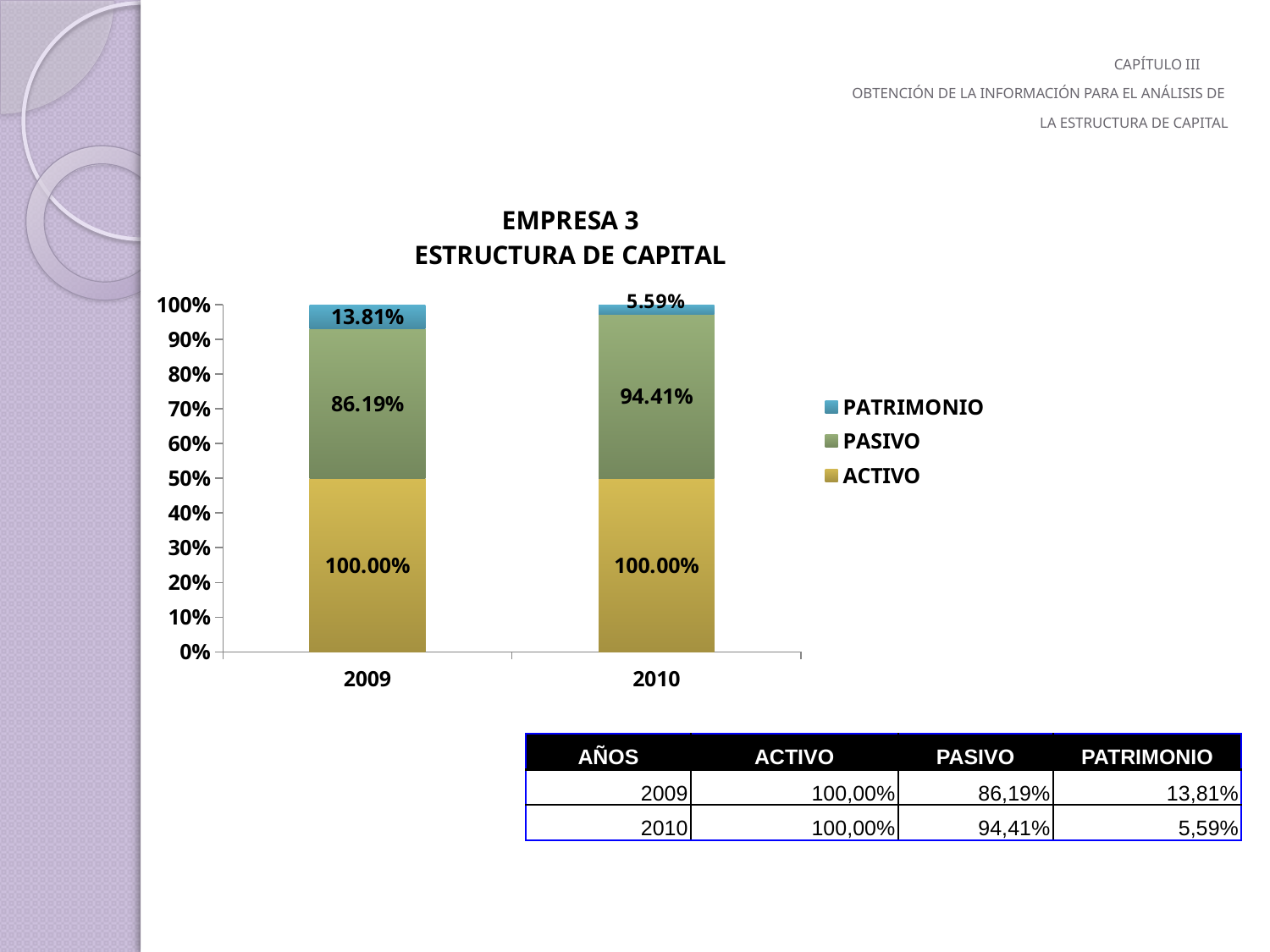
How many series does the chart legend list? 3 How many years are shown on the x axis of the chart? 2 Which year has the higher PASIVO value in the chart? 2010 What type of chart is shown on the slide? stacked bar chart What is the PASIVO value for 2009 in the chart? 86.19% Which year has the lower PATRIMONIO value in the chart? 2010 By how many percentage points does the PASIVO value change from 2009 to 2010? 8.22 What is the PATRIMONIO value for 2010 in the chart? 5.59% Does the PATRIMONIO value rise or fall from 2009 to 2010? fall What is the PATRIMONIO value for 2009 in the chart? 13.81% What is the ACTIVO value for 2010 in the chart? 100.00% What is the difference between the PATRIMONIO values for 2009 and 2010? 8.22